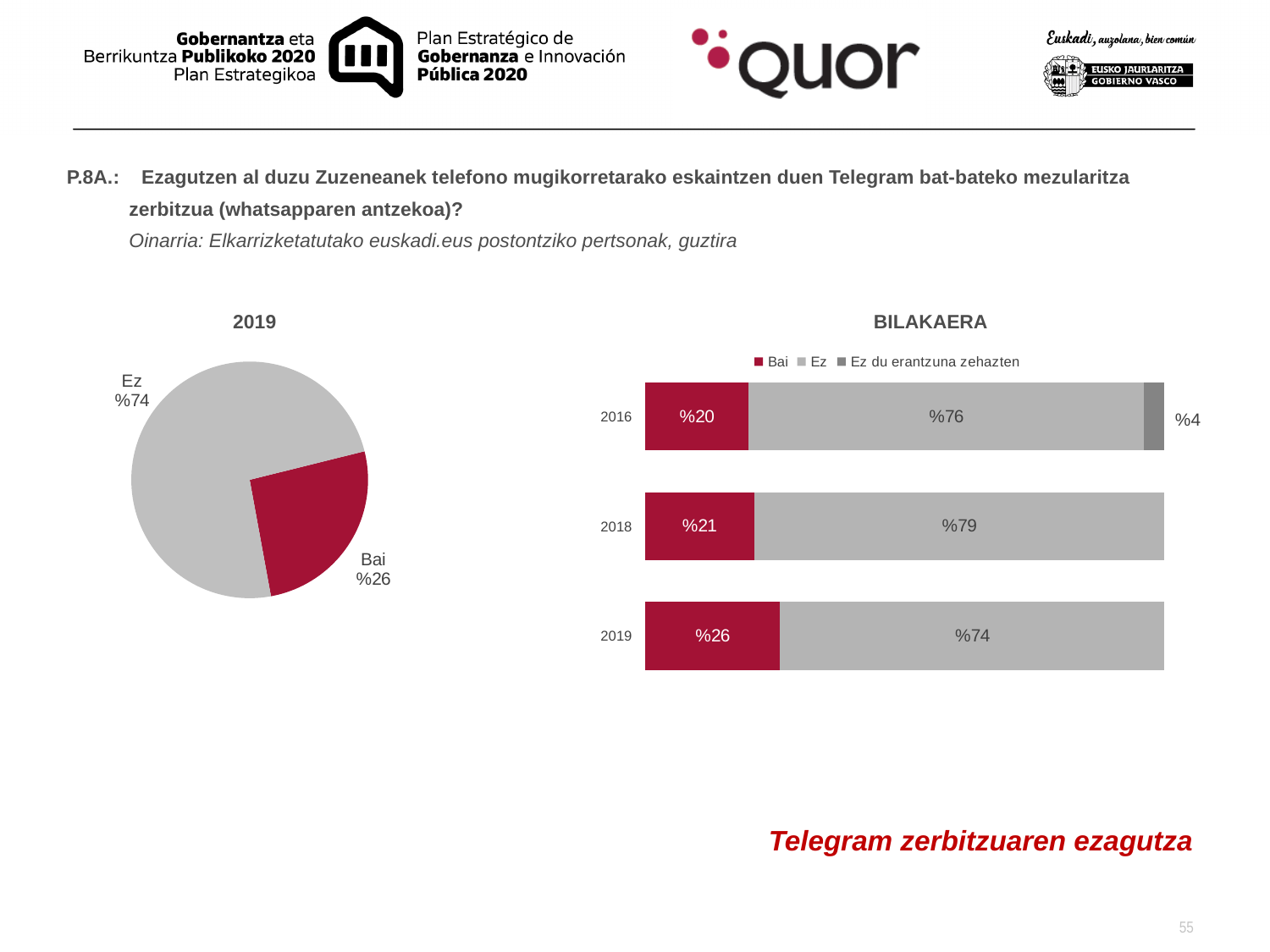
In the BILAKAERA chart, what is the difference between the Bai values for 2019 and 2016? %6 In the BILAKAERA chart, how many series does the legend list? 3 In the BILAKAERA chart, what is the value for Ez du erantzuna zehazten in 2016? %4 In the 2019 pie chart, which slice is larger, Bai or Ez? Ez In the BILAKAERA chart, what is the Ez value for 2018? %79 In the BILAKAERA chart, does the Bai value rise or fall from 2016 to 2019? rise What kind of chart is the chart titled 2019? pie chart What kind of chart is the BILAKAERA chart? bar chart In the 2019 pie chart, what share is labelled Ez? %74 In the BILAKAERA chart, what is the Bai value for 2016? %20 In the BILAKAERA chart, which year has the highest Bai value? 2019 In the 2019 pie chart, what share is labelled Bai? %26